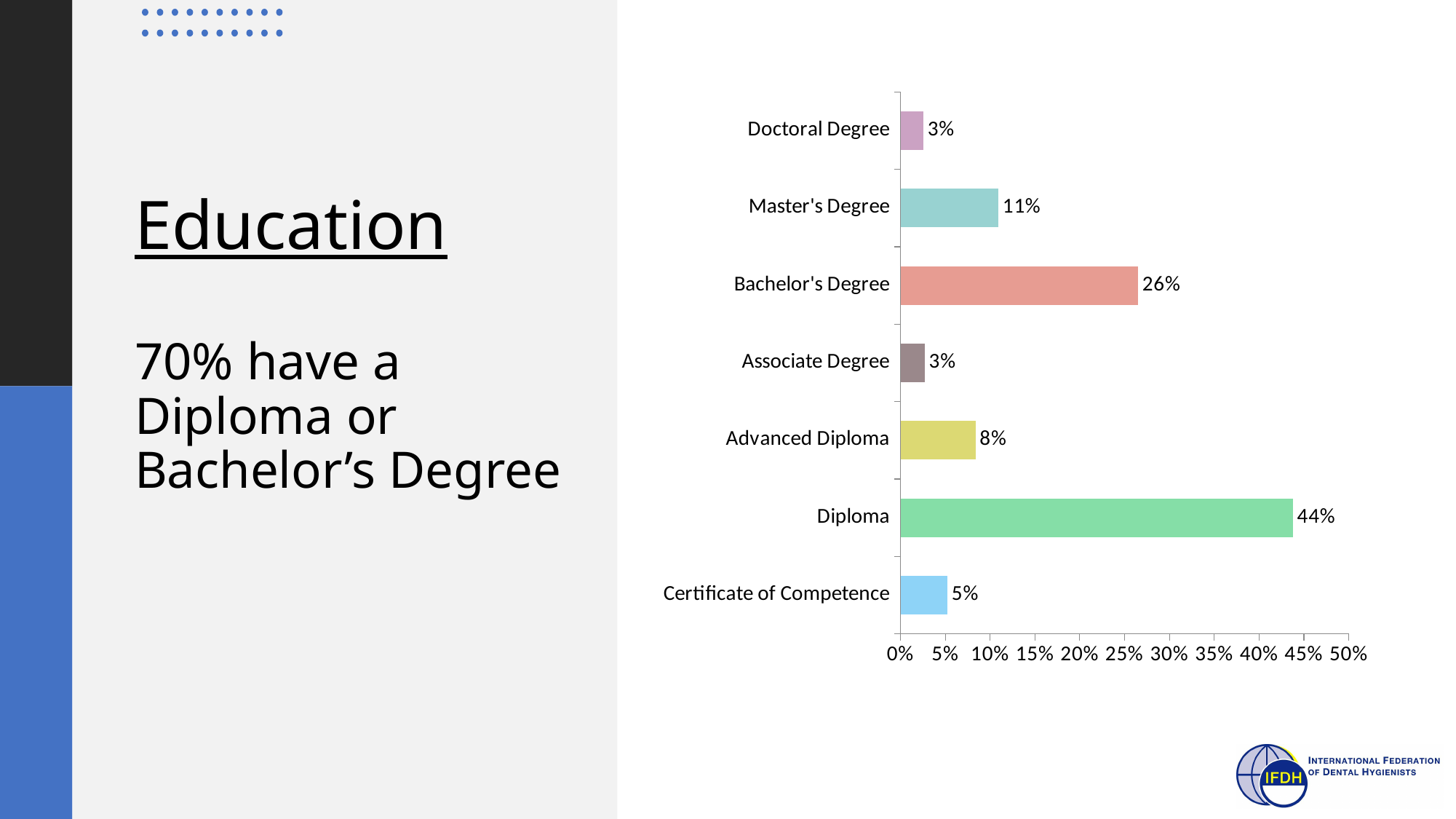
Is the value for Bachelor's Degree greater or less than 25%? greater What kind of chart is shown on the slide? Bar chart What percentage is shown for Certificate of Competence? 5% Which two categories share the same value of 3%? Doctoral Degree and Associate Degree Which is larger, the value for Advanced Diploma or the value for Master's Degree? Master's Degree How many education categories are shown in the chart? 7 What is the combined value of Diploma and Bachelor's Degree? 70% Which education category has the highest value? Diploma What percentage of respondents have a Diploma? 44% What is the difference between the Diploma and Bachelor's Degree values? 18% What is the maximum value shown on the chart's horizontal axis? 50% What is the value shown for Master's Degree? 11%